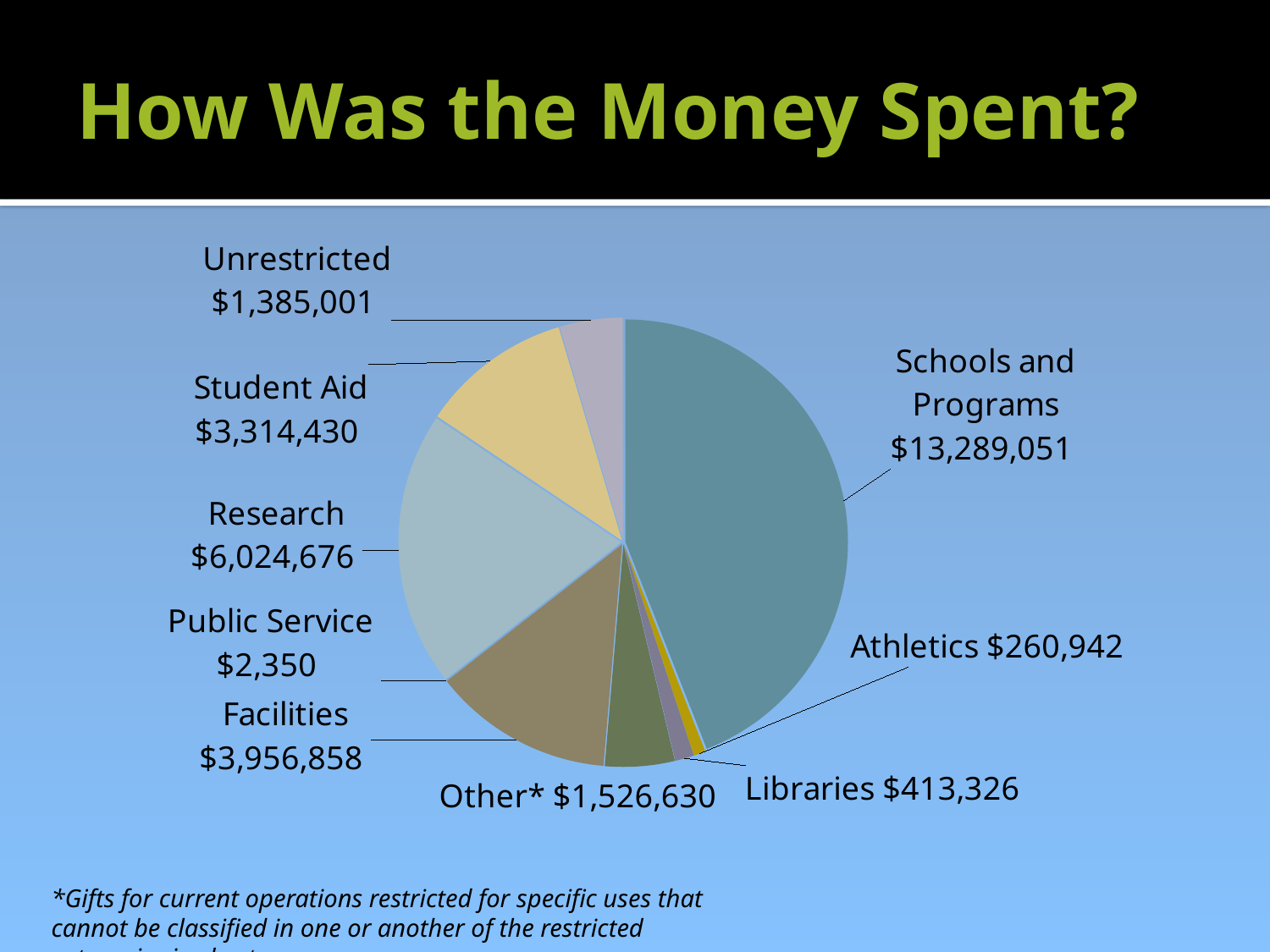
What is the total amount spent across all categories in the pie chart? $30,173,264 What amount was spent on Facilities? $3,956,858 What amount was spent on Libraries? $413,326 What kind of chart is shown on the slide? pie chart Which category received the smallest amount of money? Public Service Which received more money, Research or Facilities? Research How much more was spent on Research than on Student Aid? $2,710,246 What amount was spent on Research? $6,024,676 How many categories does the pie chart show? 9 What is the title of the slide? How Was the Money Spent? Which category received the largest amount of money? Schools and Programs How much more was spent on Libraries than on Athletics? $152,384